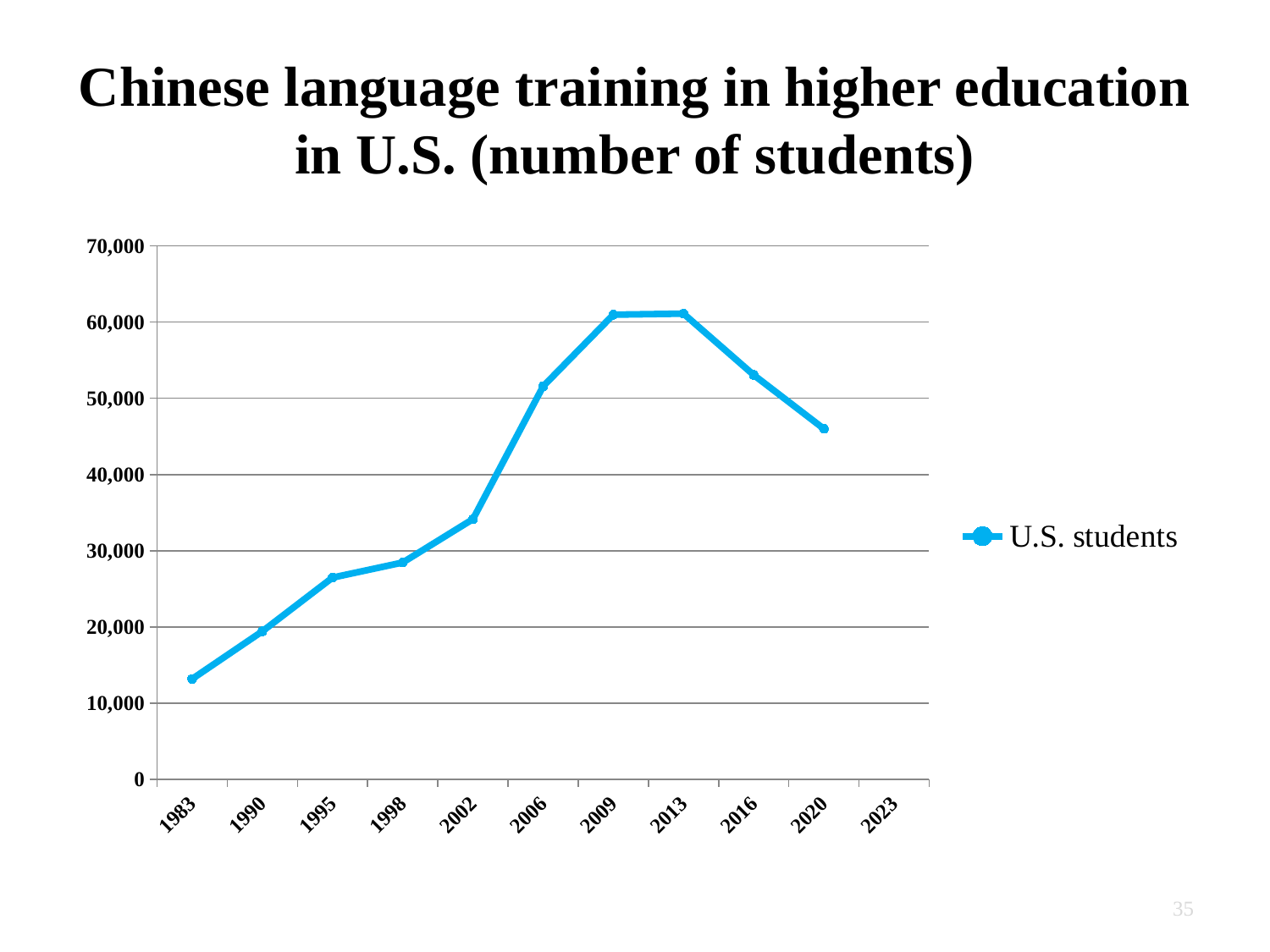
Is the value for 1983 greater or less than 20,000? less Which year has a larger value, 2016 or 2020? 2016 How many data points are plotted on the line? 10 Do the values rise or fall from 2013 to 2020? fall Is the value for 2020 greater or less than 50,000? less Is the value for 2002 greater or less than 30,000? greater What is the name of the series shown in the legend? U.S. students What kind of chart is shown on the slide? Line chart How many series does the legend list? 1 Which year has a larger value, 2002 or 2006? 2006 Which year has the lowest number of U.S. students? 1983